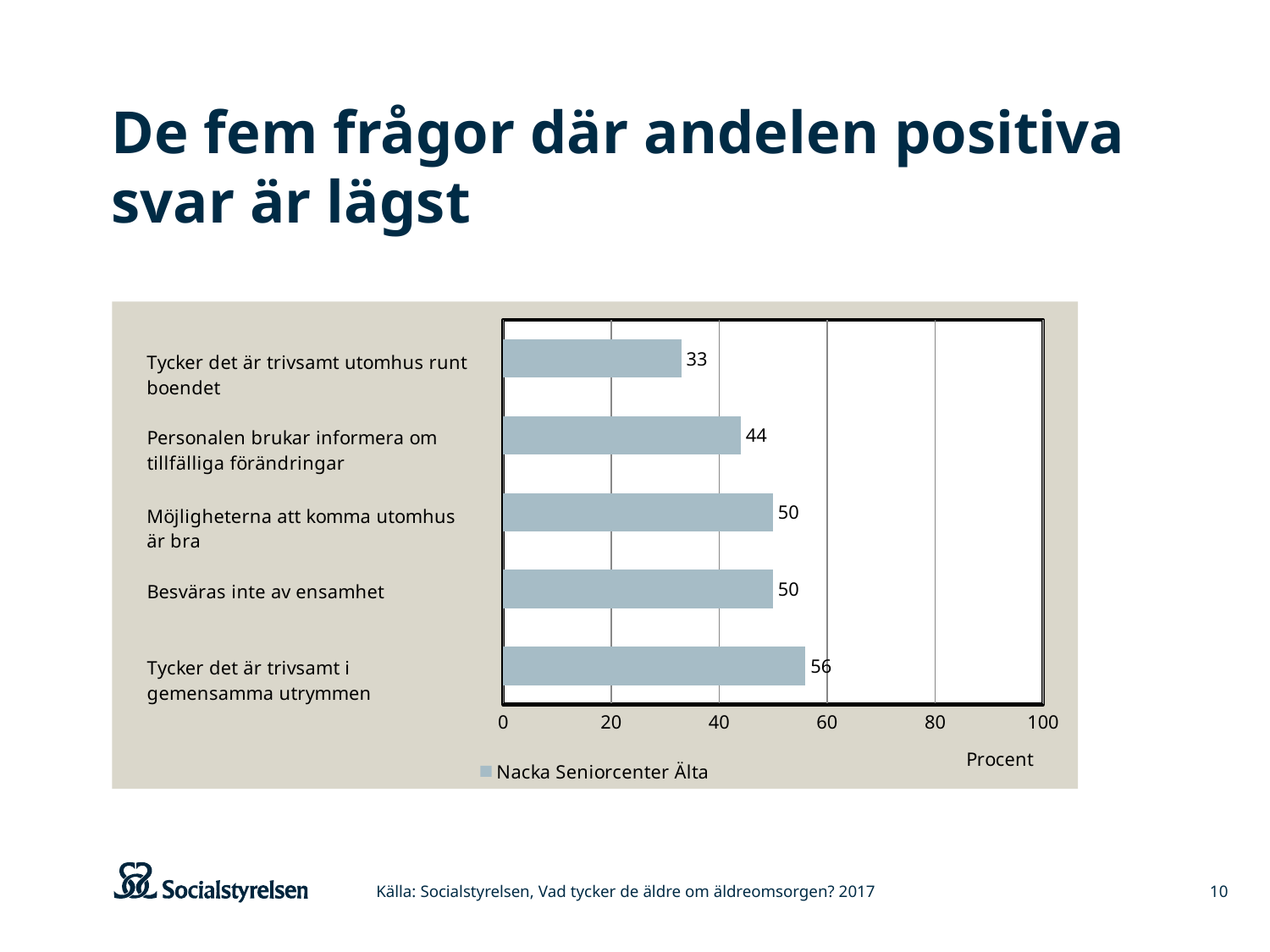
What kind of chart is shown on the slide? bar chart Is the value for "Tycker det är trivsamt utomhus runt boendet" greater or less than 40? less What is the value for "Tycker det är trivsamt i gemensamma utrymmen"? 56 Which category has the lowest value? Tycker det är trivsamt utomhus runt boendet What series does the legend list? Nacka Seniorcenter Älta How many categories are shown in the chart? 5 What is the value for "Tycker det är trivsamt utomhus runt boendet"? 33 What is the difference between the values for "Tycker det är trivsamt i gemensamma utrymmen" and "Tycker det är trivsamt utomhus runt boendet"? 23 Which category has the highest value? Tycker det är trivsamt i gemensamma utrymmen Which is larger: the value for "Personalen brukar informera om tillfälliga förändringar" or the value for "Möjligheterna att komma utomhus är bra"? Möjligheterna att komma utomhus är bra What is the value for "Personalen brukar informera om tillfälliga förändringar"? 44 What is the value for "Besväras inte av ensamhet"? 50